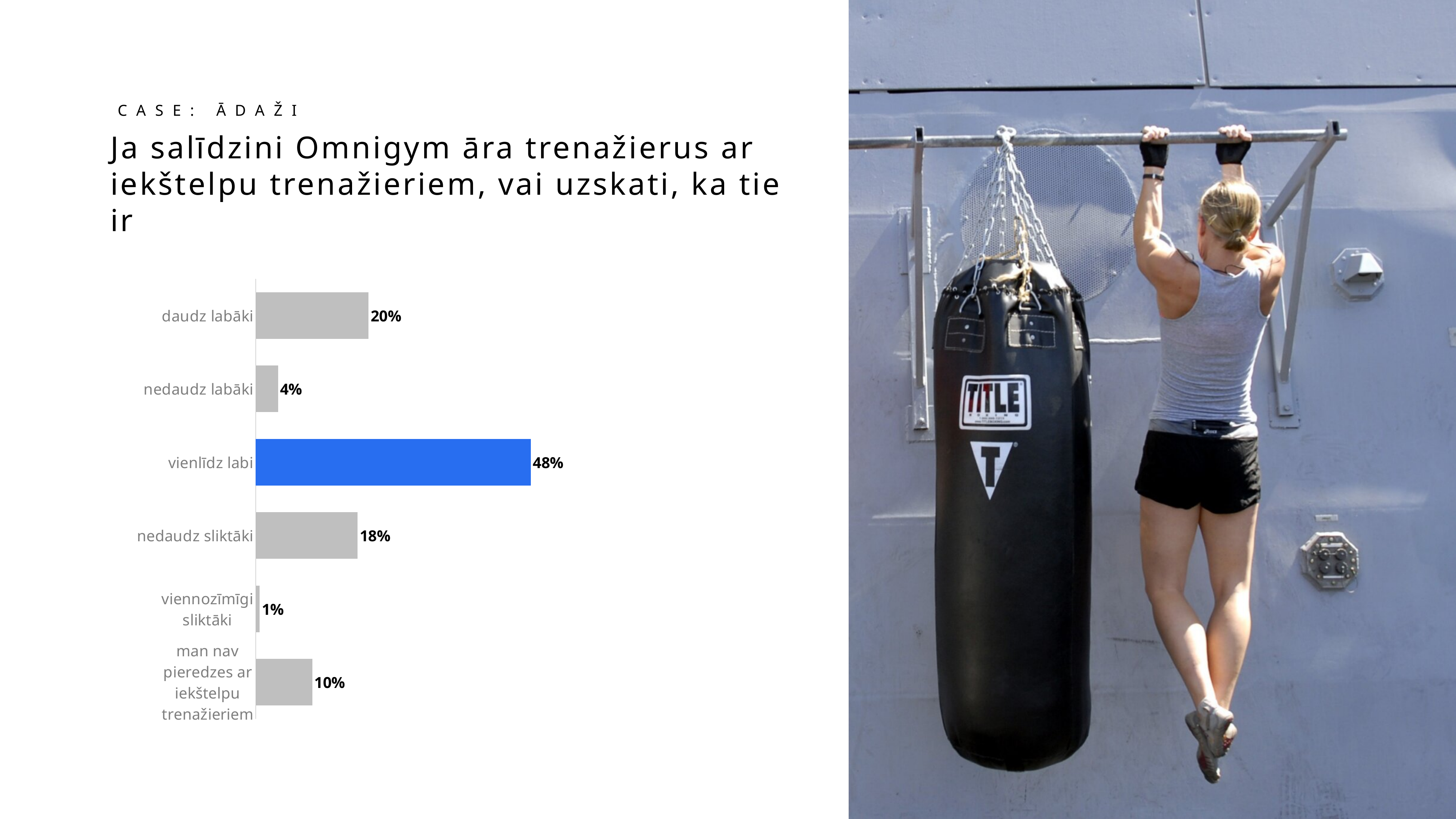
Which category has the highest value? vienlīdz labi What kind of chart is shown on the slide? bar chart Which category has the lowest value? viennozīmīgi sliktāki How many categories are shown in the chart? 6 Which is larger, the value for "daudz labāki" or the value for "nedaudz sliktāki"? daudz labāki What is the difference between the values for "vienlīdz labi" and "daudz labāki"? 28% What is the value for "nedaudz sliktāki"? 18% What is the value for "daudz labāki"? 20% What is the value for "man nav pieredzes ar iekštelpu trenažieriem"? 10% What is the difference between the values for "nedaudz sliktāki" and "nedaudz labāki"? 14% Which bar is highlighted in blue? vienlīdz labi What is the value for "vienlīdz labi"? 48%